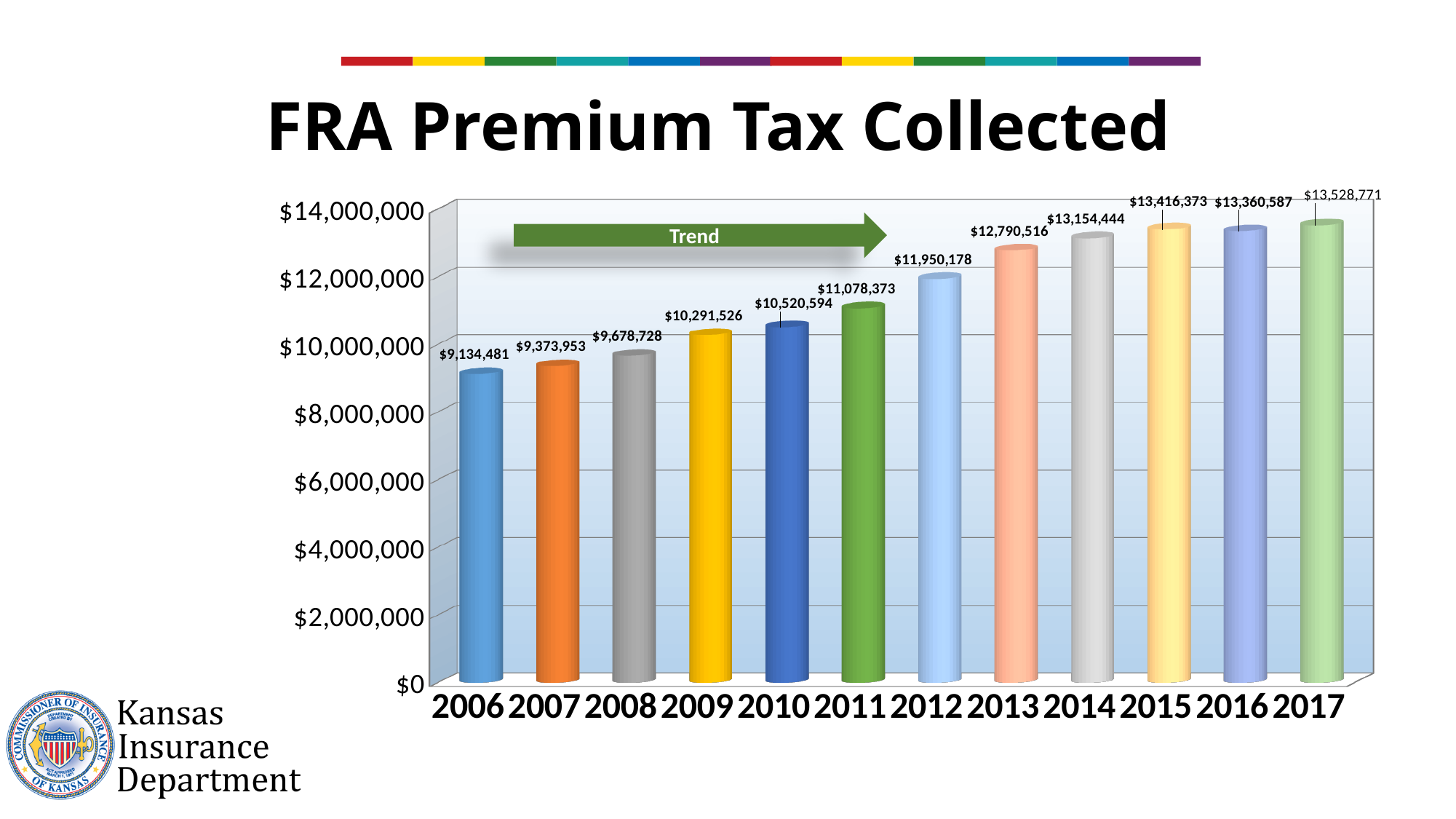
Is the FRA premium tax collected in 2009 greater or less than $10,000,000? greater Which year had the lowest FRA premium tax collected? 2006 Do the FRA premium tax values generally rise or fall from 2006 to 2017? rise What was the FRA premium tax collected in 2012? $11,950,178 How many years are shown on the chart? 12 What kind of chart is used to show the FRA premium tax collected? bar chart What was the FRA premium tax collected in 2006? $9,134,481 How much more FRA premium tax was collected in 2017 than in 2006? $4,394,290 Which year had a larger FRA premium tax collected, 2015 or 2016? 2015 What was the FRA premium tax collected in 2017? $13,528,771 What is the difference between the FRA premium tax collected in 2012 and in 2011? $871,805 Which year had the highest FRA premium tax collected? 2017